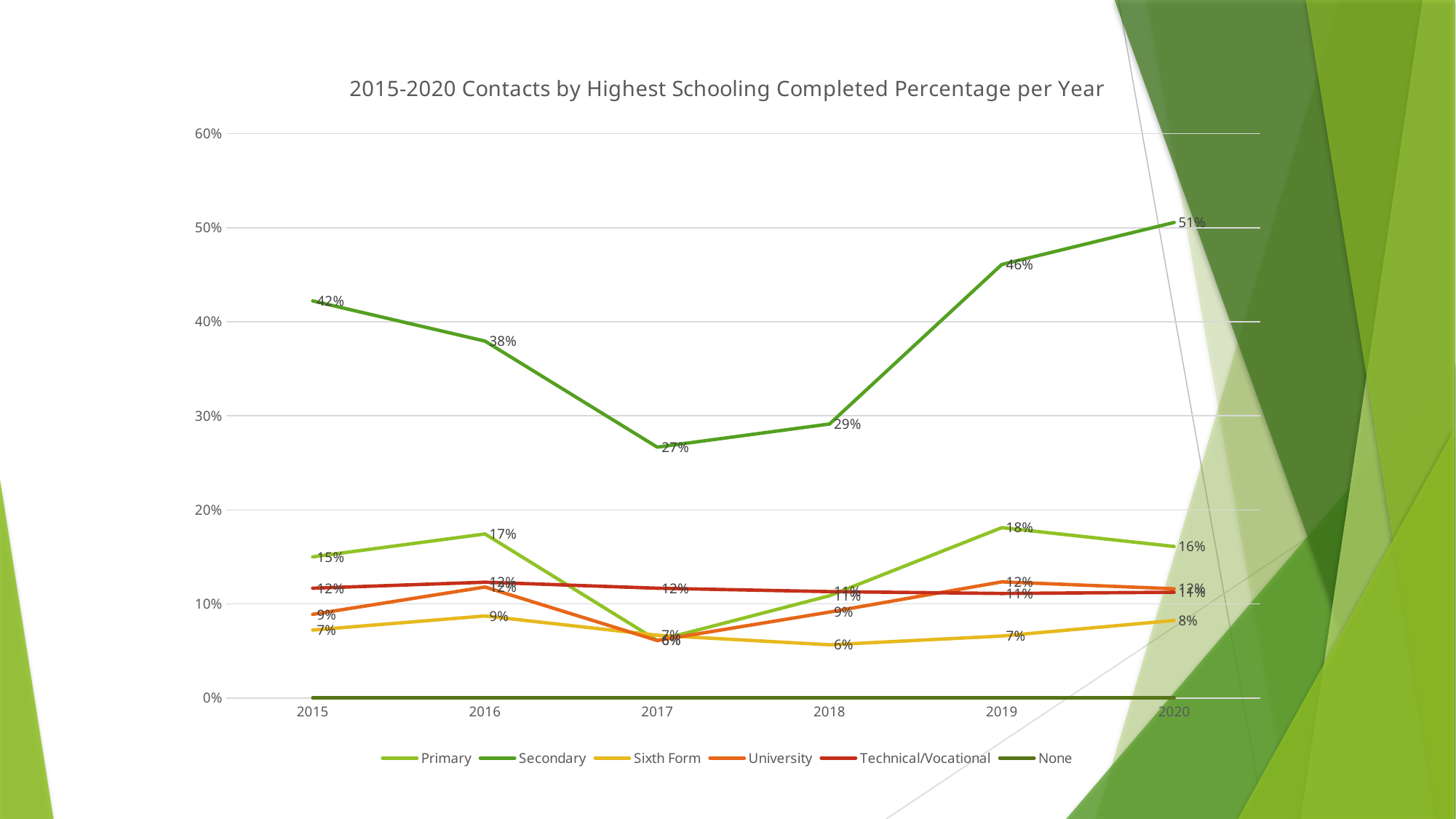
What is the Secondary value for 2017? 27% What kind of chart is shown on the slide? Line chart Is the Secondary value for 2015 greater or less than 40%? greater What is the Secondary value for 2020? 51% What is the Primary value for 2019? 18% How many years are plotted along the x axis? 6 Which is larger in 2016, Primary or Secondary? Secondary How many series does the legend list? 6 In which year is the Secondary series lowest? 2017 Does the Secondary series rise or fall from 2017 to 2020? Rise What is the difference between the Secondary values for 2020 and 2019? 5 percentage points In which year is the Secondary series highest? 2020